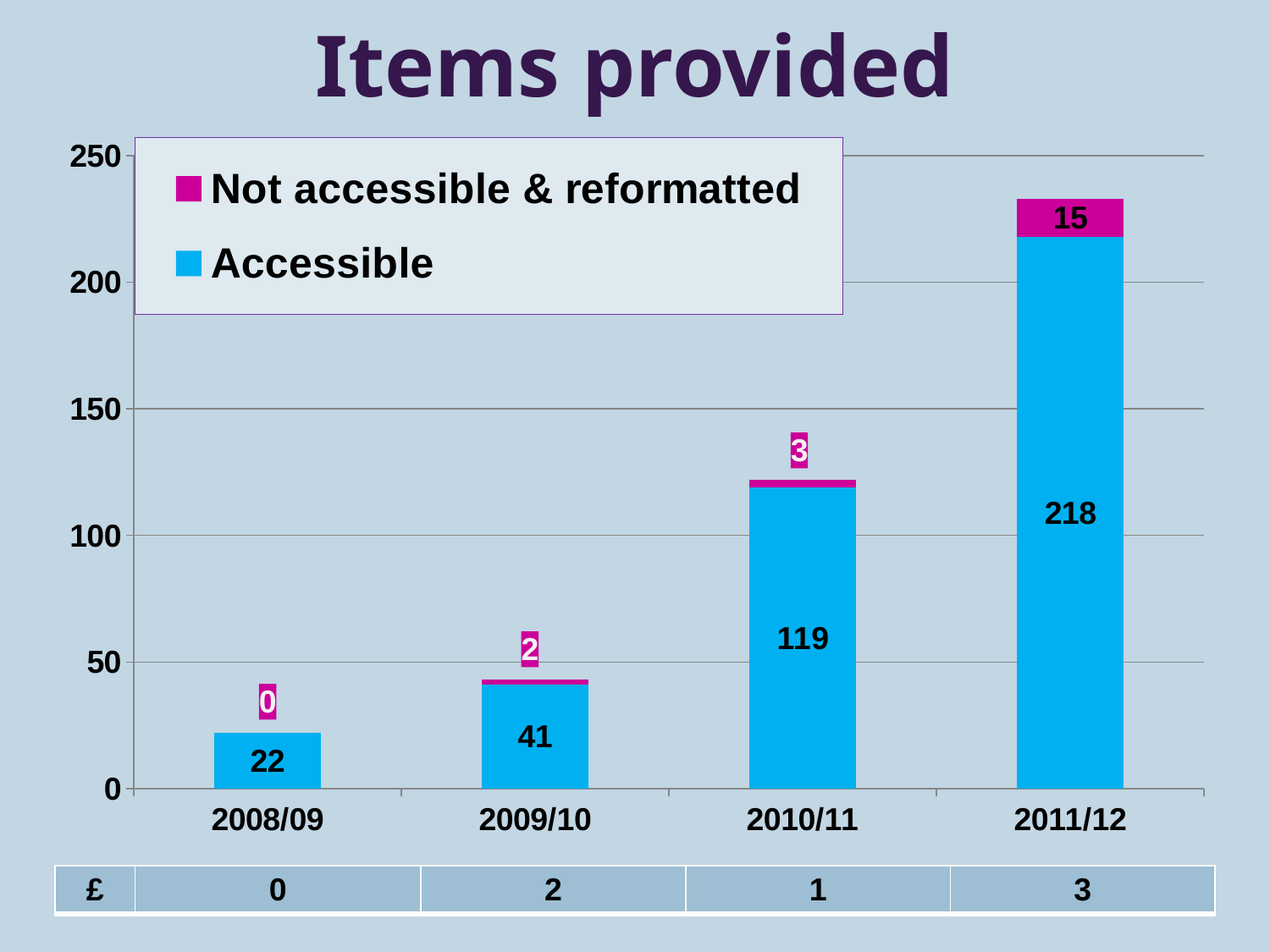
Which year has the lowest Accessible value? 2008/09 How many years are shown on the x axis? 4 What is the total of the stacked bar for 2011/12? 233 How many series does the legend list? 2 What kind of chart is shown? Stacked bar chart Which year has the highest Accessible value? 2011/12 What is the Not accessible & reformatted value for 2010/11? 3 What is the difference between the Accessible values for 2011/12 and 2010/11? 99 Do the Accessible values rise or fall from 2008/09 to 2011/12? Rise Which is larger, the Accessible value for 2009/10 or for 2010/11? 2010/11 What is the Accessible value for 2011/12? 218 What is the Accessible value for 2009/10? 41